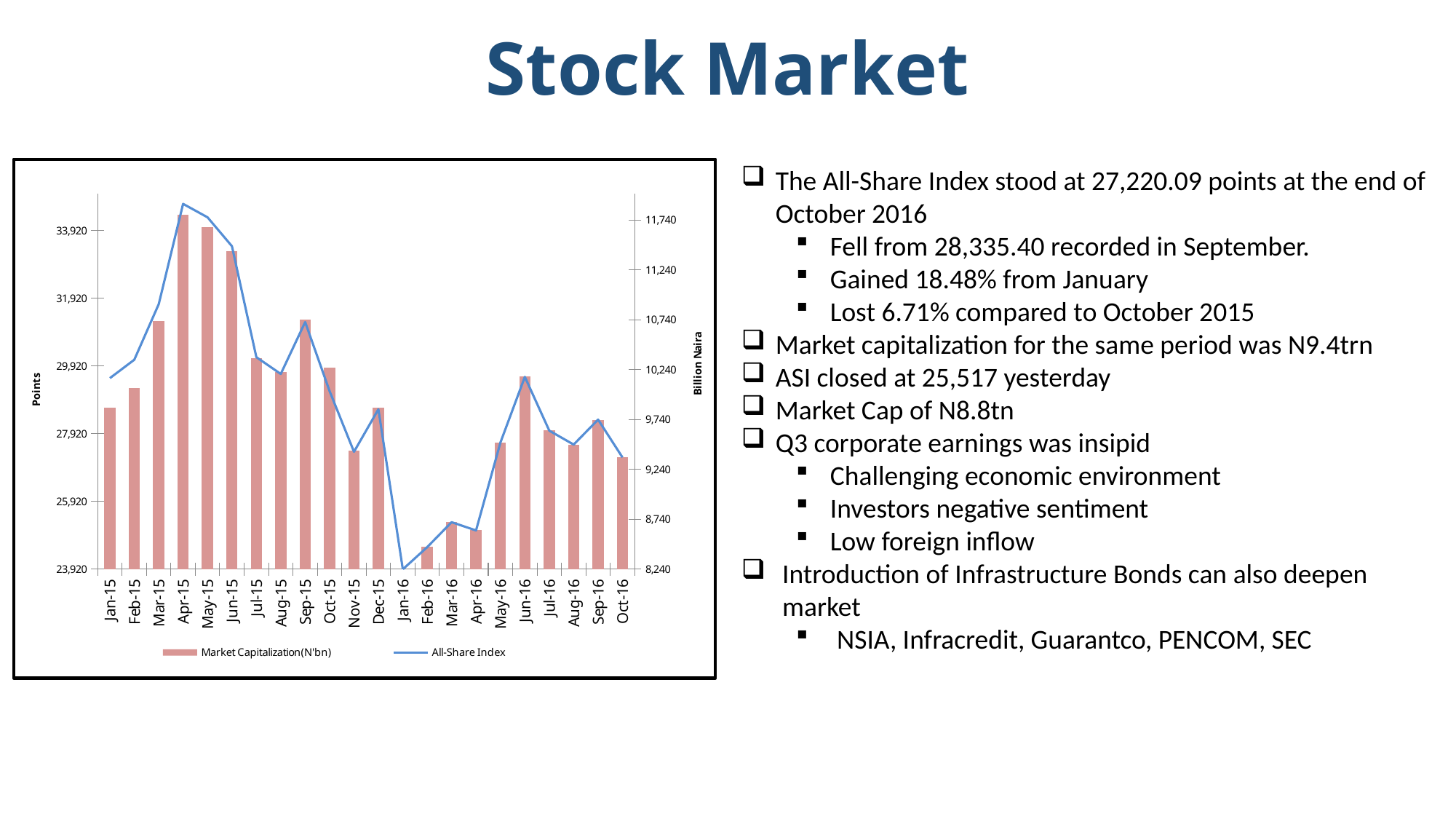
Which month has the lowest Market Capitalization bar? Jan-16 Which month has the highest Market Capitalization bar? Apr-15 Which month has the larger Market Capitalization bar, Jun-16 or Dec-15? Jun-16 Is the All-Share Index value for Jan-16 greater or less than 25,920? less How many months are plotted along the x axis of the chart? 22 How many series does the chart's legend list? 2 What kind of chart is shown on the slide? A combined bar and line chart In which month does the All-Share Index line reach its lowest point? Jan-16 Is the Market Capitalization value for Apr-15 greater or less than 11,240? greater In which month does the All-Share Index line reach its highest point? Apr-15 Is the Market Capitalization value for Oct-16 greater or less than 9,740? less Does the All-Share Index line rise or fall between Apr-15 and Jan-16? Fall